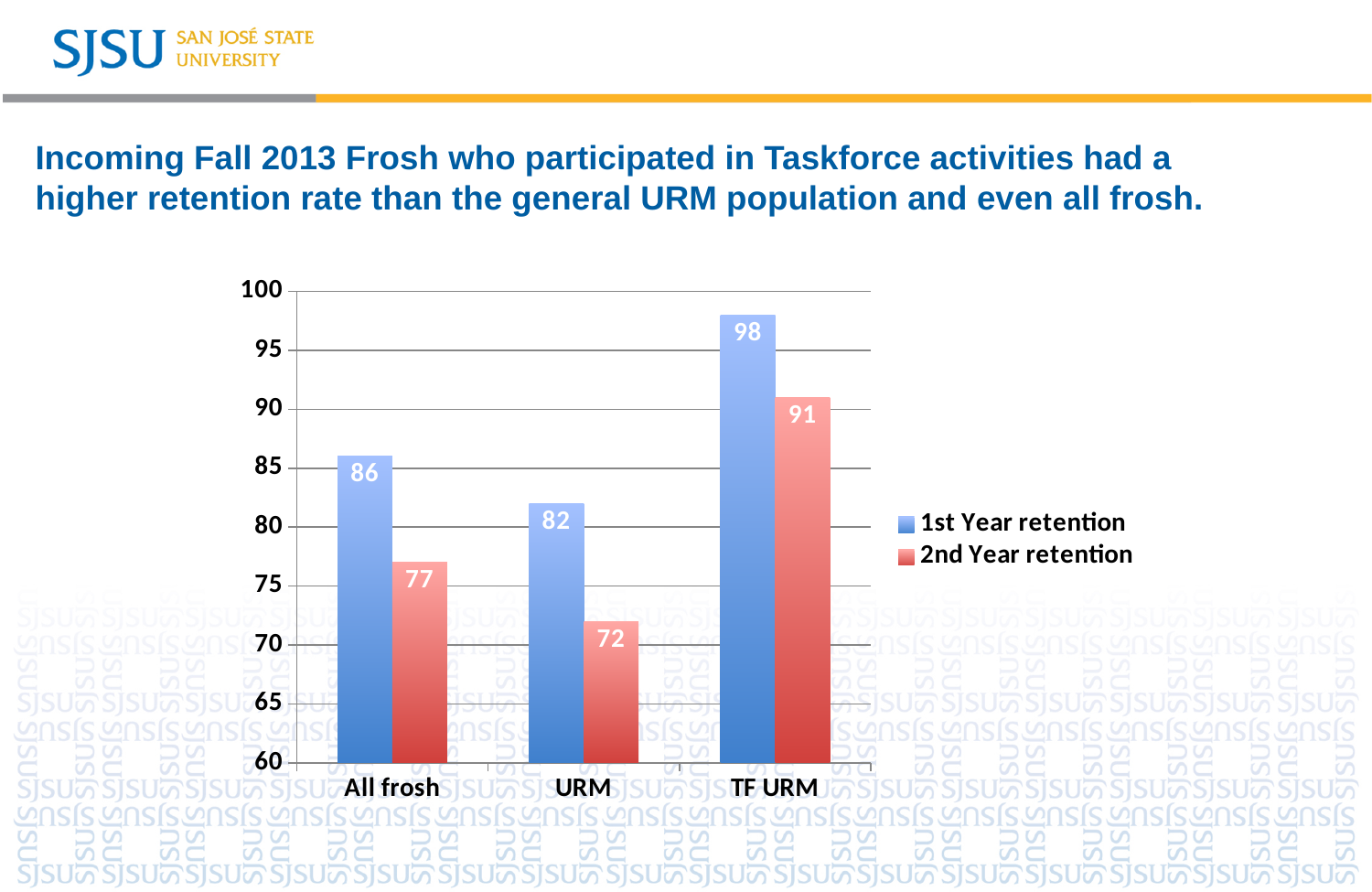
What is the 1st Year retention value for TF URM? 98 What is the difference between the 1st Year retention and 2nd Year retention for TF URM? 7 What kind of chart is shown on the slide? Bar chart What is the 2nd Year retention value for URM? 72 What is the 2nd Year retention value for All frosh? 77 What is the difference in 2nd Year retention between TF URM and URM? 19 Which category has the lowest 2nd Year retention? URM Which category has the highest 1st Year retention? TF URM How many series does the legend list? 2 Which is larger: the 1st Year retention for All frosh or for URM? All frosh How many categories are shown on the x axis? 3 What colour are the 2nd Year retention bars? Red